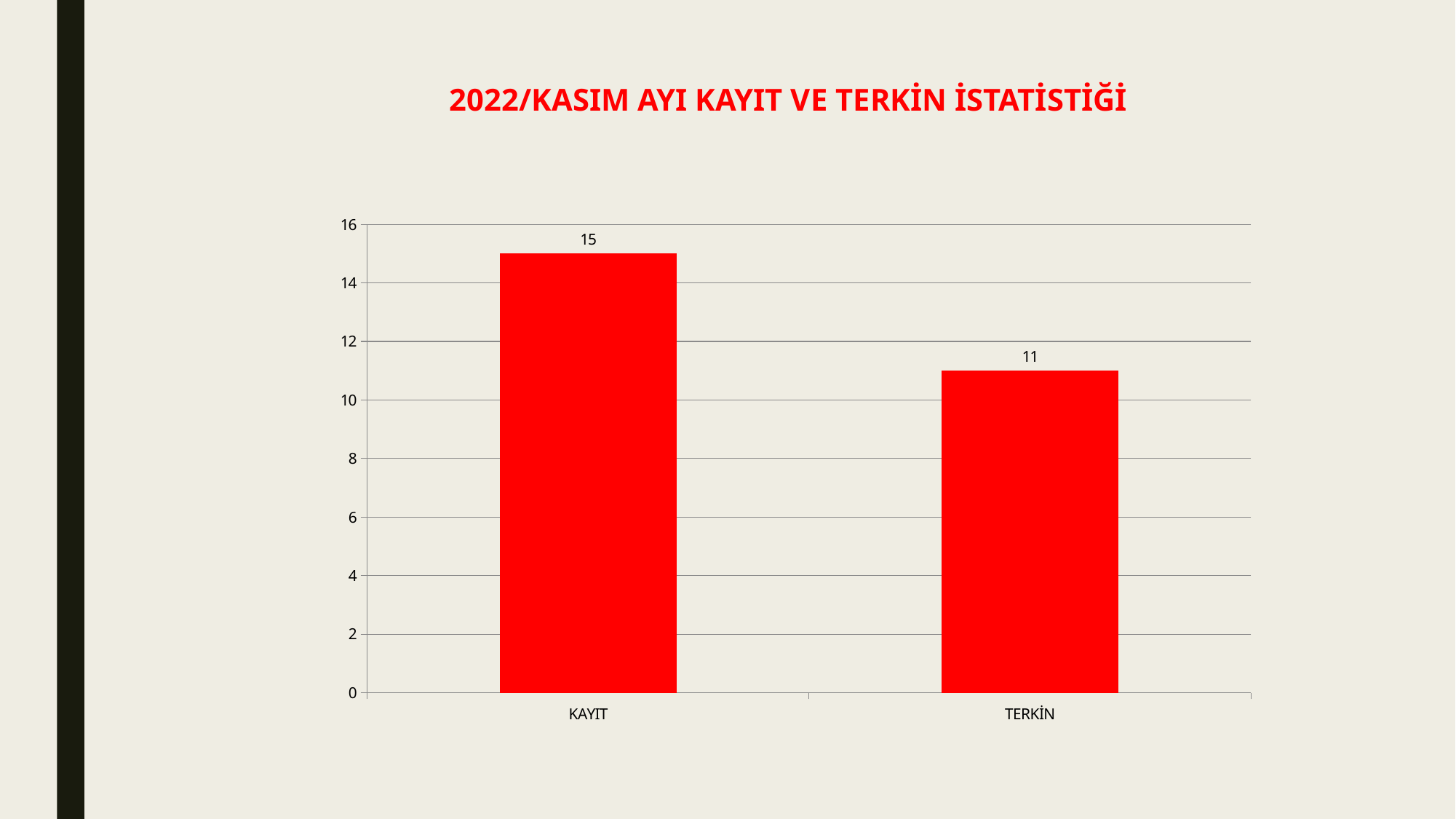
What is the value for KAYIT? 15 What kind of chart is shown on the slide? bar chart Is the value for KAYIT greater or less than 14? greater What colour are the bars in the chart? red What is the difference between the values for KAYIT and TERKİN? 4 What is the title of the chart? 2022/KASIM AYI KAYIT VE TERKİN İSTATİSTİĞİ Which category has the highest value? KAYIT Which category has the lowest value? TERKİN Is the value for TERKİN greater or less than 12? less What is the value for TERKİN? 11 How many categories are shown on the x axis? 2 Which is larger, the value for KAYIT or the value for TERKİN? KAYIT